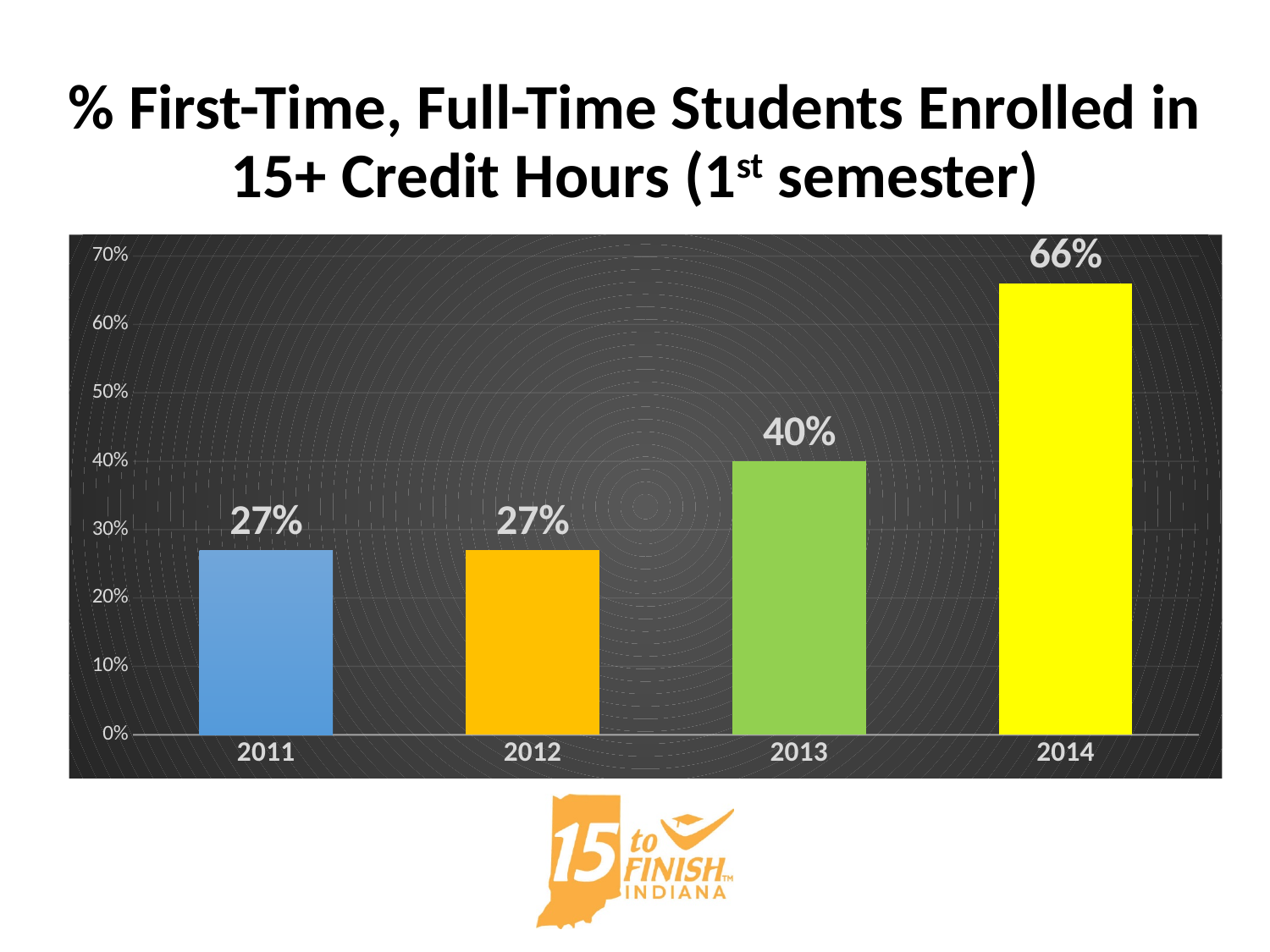
Is the value for 2014 greater or less than 60%? greater How many years are shown on the x axis? 4 What is the value for 2014? 66% What is the difference between the values for 2014 and 2013? 26% What is the value for 2011? 27% What kind of chart is shown on the slide? bar chart What is the difference between the values for 2013 and 2012? 13% Which year has the highest value? 2014 Do the values rise or fall from 2012 to 2014? rise What colour is the bar for 2014? yellow What is the value for 2013? 40% Which is larger, the value for 2013 or the value for 2012? 2013